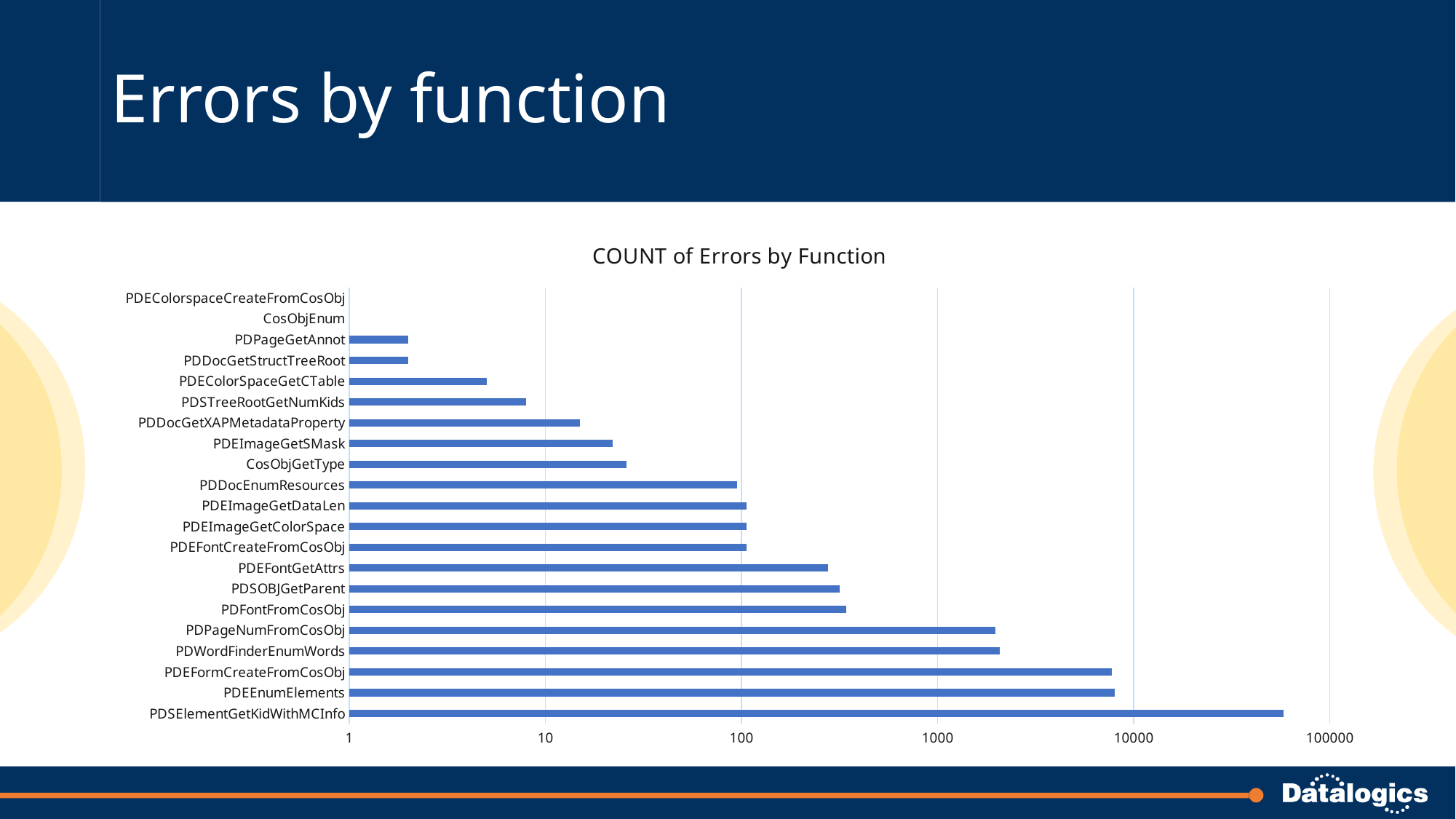
Is the value for PDSElementGetKidWithMCInfo greater or less than 10000? greater Is the value for PDEFontGetAttrs greater or less than 100? greater Is the value for PDEImageGetSMask greater or less than 10? greater What kind of chart is shown on the slide? bar chart Which has more errors, PDPageGetAnnot or PDEImageGetSMask? PDEImageGetSMask How many functions (categories) are listed on the chart? 21 Which function has the highest count of errors? PDSElementGetKidWithMCInfo What is the title of the chart? COUNT of Errors by Function What is the largest value labelled on the horizontal axis? 100000 Which has more errors, PDEFormCreateFromCosObj or PDWordFinderEnumWords? PDEFormCreateFromCosObj